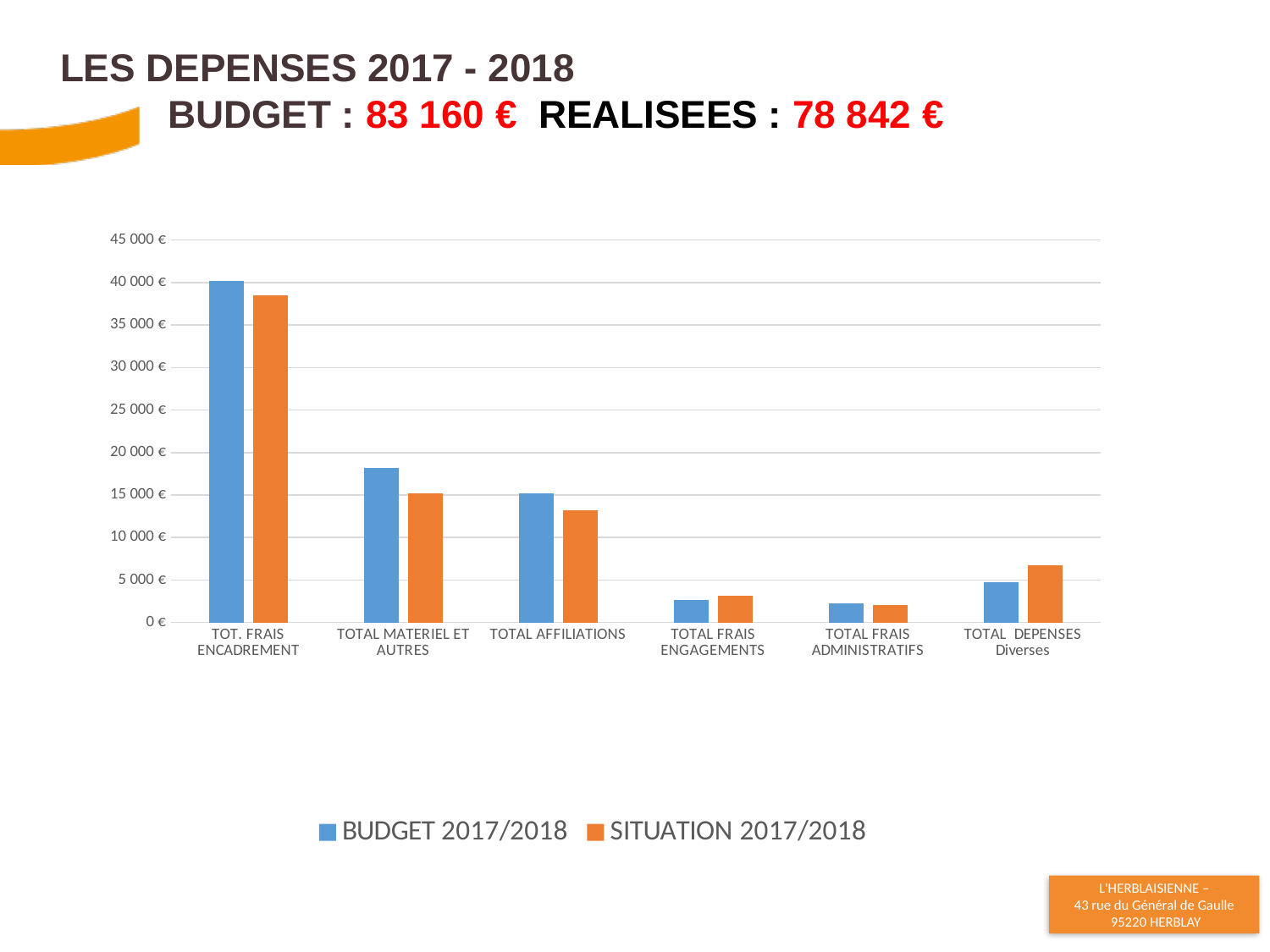
For TOTAL DEPENSES Diverses, which is larger: BUDGET 2017/2018 or SITUATION 2017/2018? SITUATION 2017/2018 Which category has the highest BUDGET 2017/2018 value? TOT. FRAIS ENCADREMENT For TOTAL MATERIEL ET AUTRES, which is larger: BUDGET 2017/2018 or SITUATION 2017/2018? BUDGET 2017/2018 Is the BUDGET 2017/2018 value for TOTAL FRAIS ADMINISTRATIFS greater or less than 5 000 €? less Which category has the lowest SITUATION 2017/2018 value? TOTAL FRAIS ADMINISTRATIFS Is the BUDGET 2017/2018 value for TOT. FRAIS ENCADREMENT greater or less than 35 000 €? greater What kind of chart is shown on the slide? bar chart Is the SITUATION 2017/2018 value for TOTAL DEPENSES Diverses greater or less than 5 000 €? greater How many categories are shown on the x axis of the chart? 6 Which colour represents the SITUATION 2017/2018 series in the chart? orange How many series does the legend list? 2